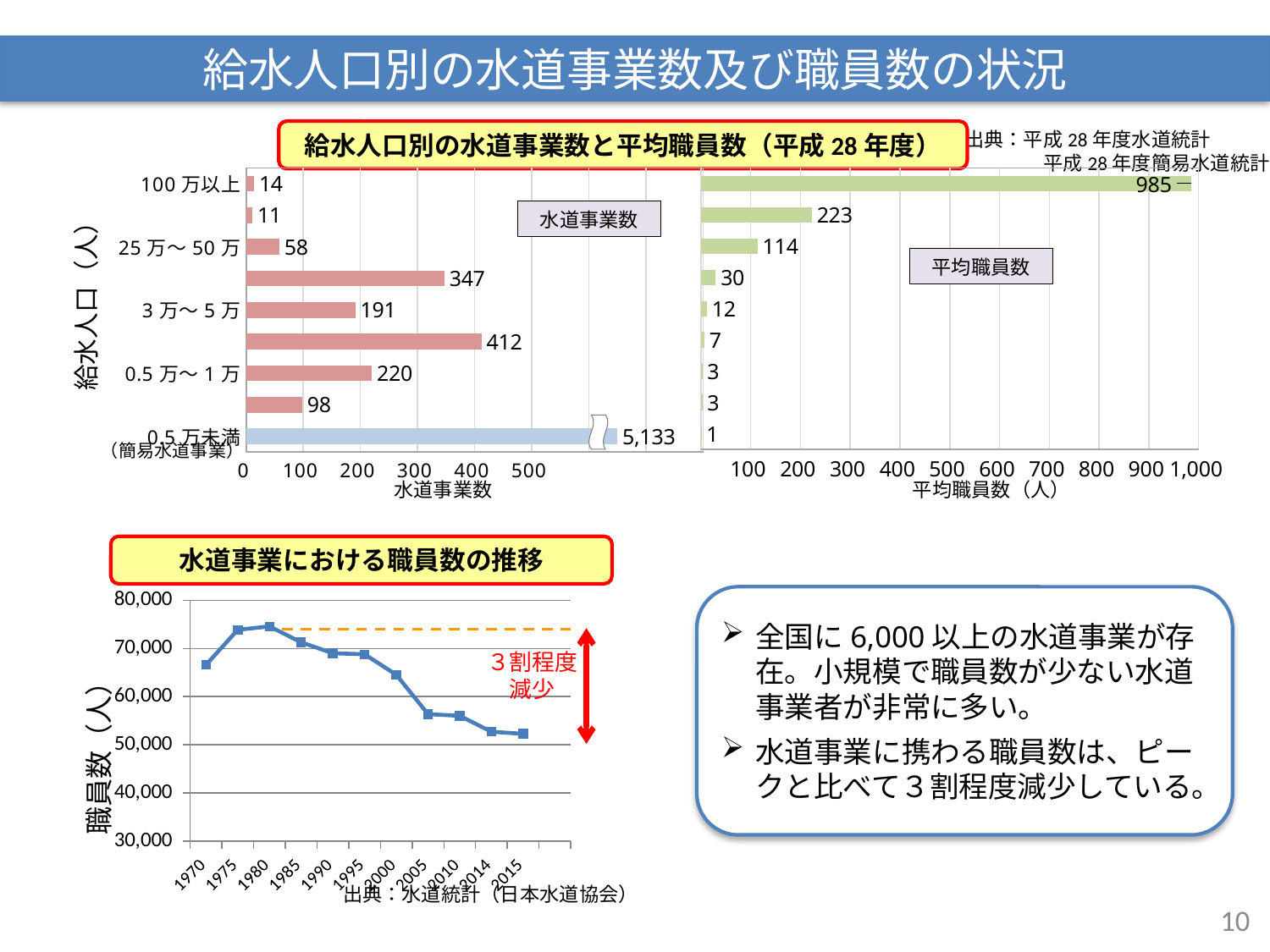
In the top-left chart (水道事業数), what is the difference between the values for 0.5万～1万 and 25万～50万? 162 In the top-left chart (水道事業数), which is larger, the value for 3万～5万 or the value for 0.5万～1万? 0.5万～1万 How many bars are plotted in the top-left chart (水道事業数)? 9 In the bottom-left chart (水道事業における職員数の推移), do the values rise or fall from 1985 to 2015? fall In the top-left chart (水道事業数), what is the value for 100万以上? 14 In the top-right chart (平均職員数), which category has the lowest value? 0.5万未満 (簡易水道事業) In the top-right chart (平均職員数), what is the value for 100万以上? 985 In the bottom-left chart (水道事業における職員数の推移), is the value for 2015 greater or less than 60,000? less In the top-left chart (水道事業数), what is the value for 0.5万未満 (簡易水道事業)? 5,133 What kind of chart is the bottom-left chart (水道事業における職員数の推移)? line chart In the top-left chart (水道事業数), what is the value for 3万～5万? 191 In the top-right chart (平均職員数), what is the value for 25万～50万? 114